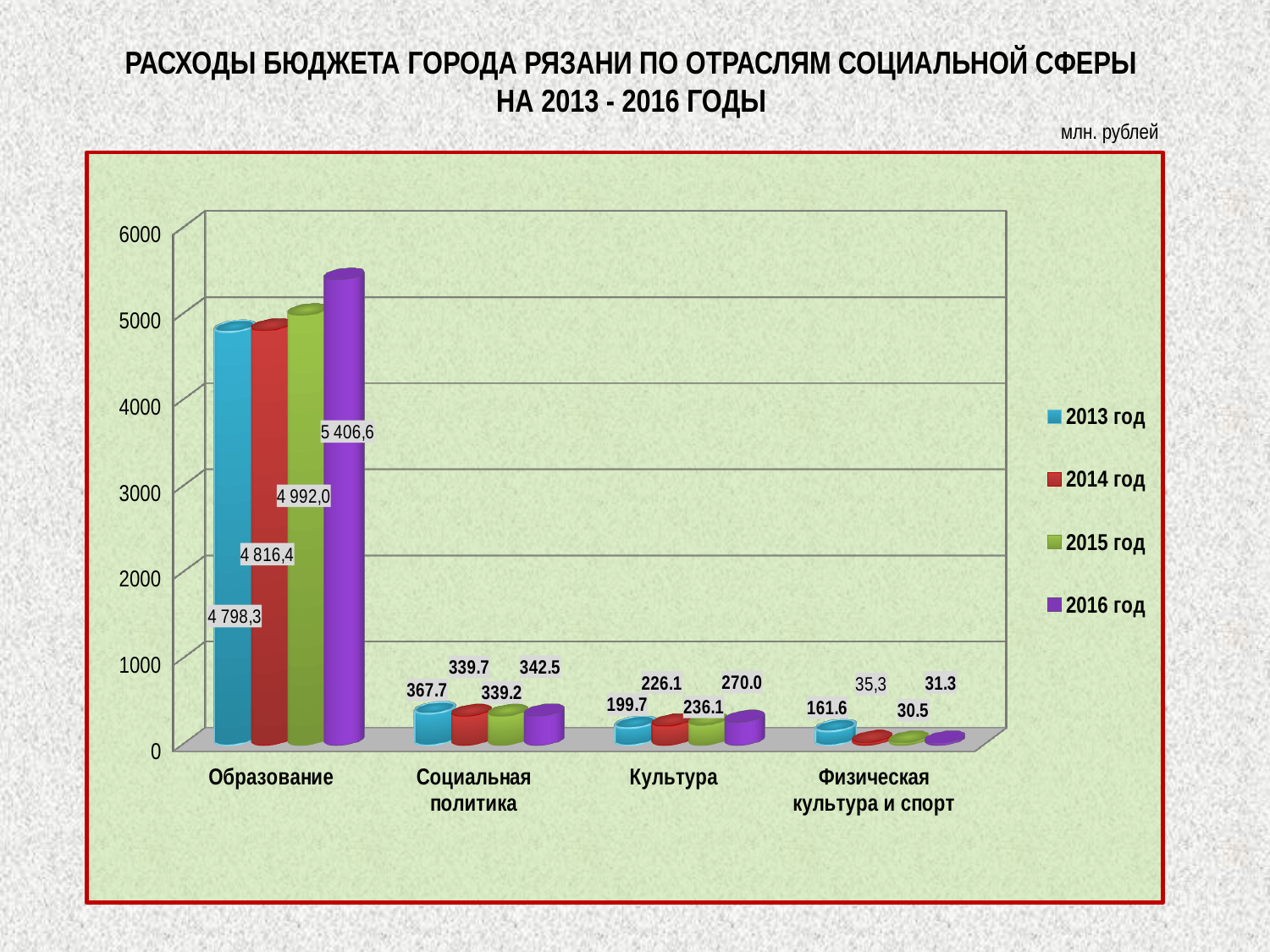
Which is larger for Социальная политика: the 2013 год value or the 2014 год value? 2013 год Which category has the lowest value in 2016 год? Физическая культура и спорт Is the value for Образование in 2016 год greater or less than 5000? greater What is the value for Образование in 2016 год? 5 406,6 Which category has the highest values across all years? Образование What is the difference between the 2016 год and 2013 год values for Культура? 70.3 What is the value for Социальная политика in 2013 год? 367.7 What is the value for Культура in 2015 год? 236.1 What is the value for Физическая культура и спорт in 2014 год? 35,3 Do the values for Образование rise or fall from 2013 год to 2016 год? rise How many series does the legend list? 4 How many categories are shown on the x axis? 4